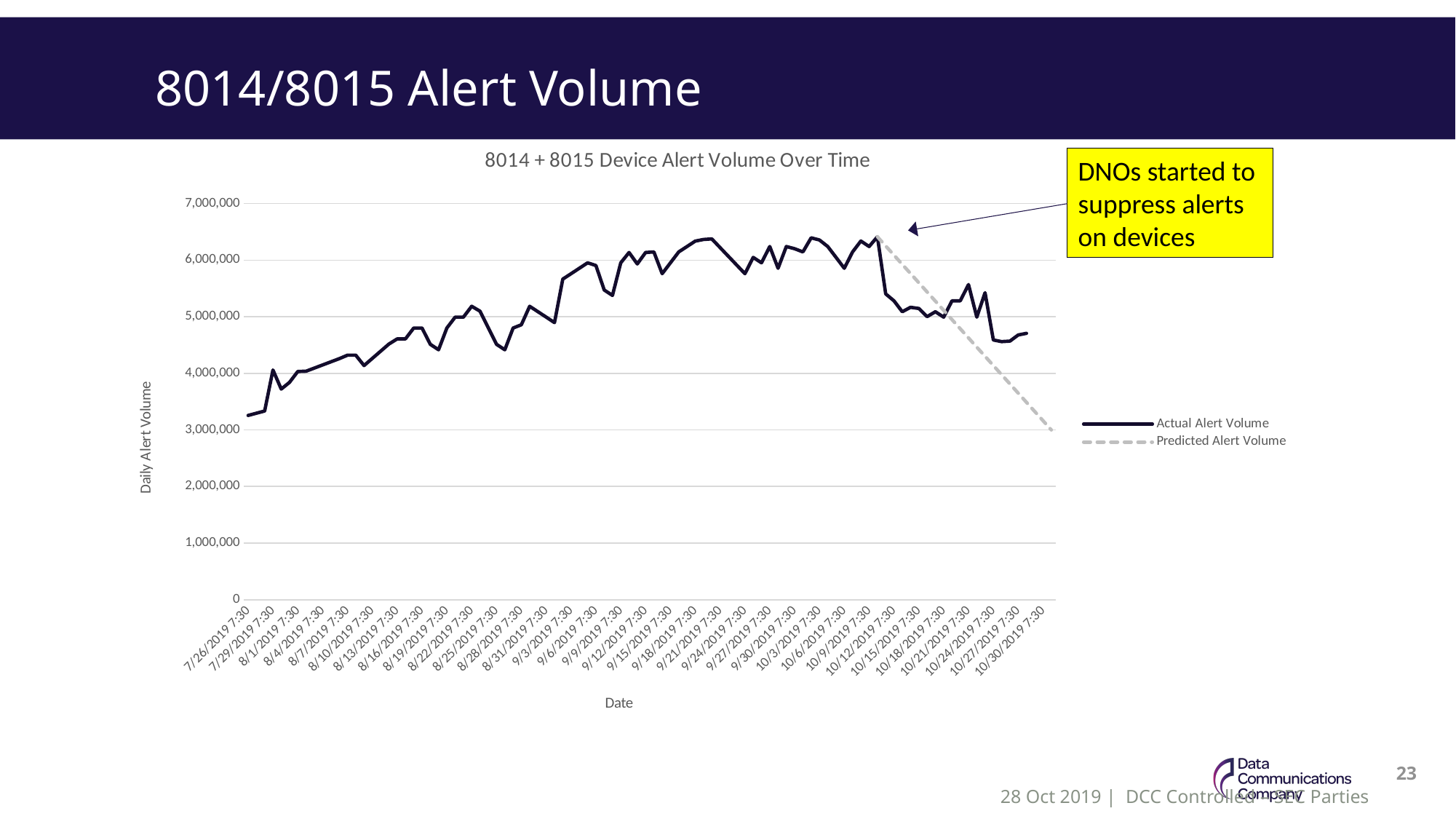
Does the Actual Alert Volume generally rise or fall between 7/26/2019 and early October 2019? rise Is the Actual Alert Volume on 7/26/2019 7:30 greater or less than 4,000,000? less Does the peak of the Actual Alert Volume line exceed 7,000,000? No What is the title of the chart? 8014 + 8015 Device Alert Volume Over Time Is the Actual Alert Volume on 7/26/2019 7:30 greater or less than 3,000,000? greater Which series is drawn with a dashed grey line? Predicted Alert Volume What kind of chart is shown on the slide? line chart How many series does the chart legend list? 2